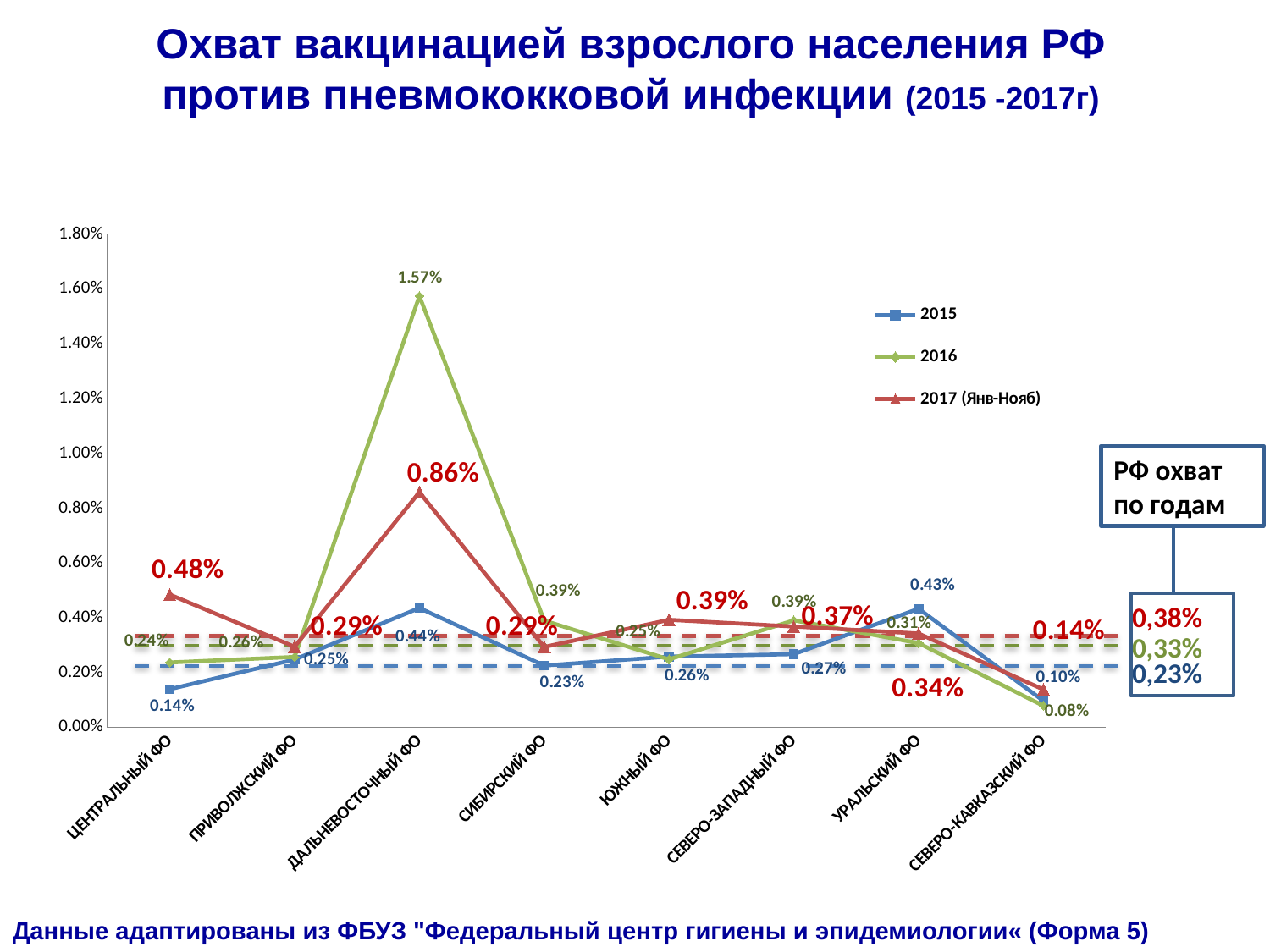
What is the 2017 (Янв-Нояб) value for Дальневосточный ФО? 0.86% How many federal districts (categories) are plotted along the x axis? 8 How many series does the legend list? 3 What is the difference between the 2016 and 2017 (Янв-Нояб) values for Дальневосточный ФО? 0.71% What is the 2017 (Янв-Нояб) value for Центральный ФО? 0.48% What kind of chart is shown on the slide? line chart For Уральский ФО, which is larger: the 2015 value or the 2017 (Янв-Нояб) value? 2015 What is the 2016 value for Дальневосточный ФО? 1.57% Which federal district has the lowest 2017 (Янв-Нояб) value? Северо-Кавказский ФО Which federal district has the highest 2016 value? Дальневосточный ФО What is the 2015 value for Уральский ФО? 0.43% According to the box 'РФ охват по годам', what is the RF coverage shown in red (2017)? 0,38%